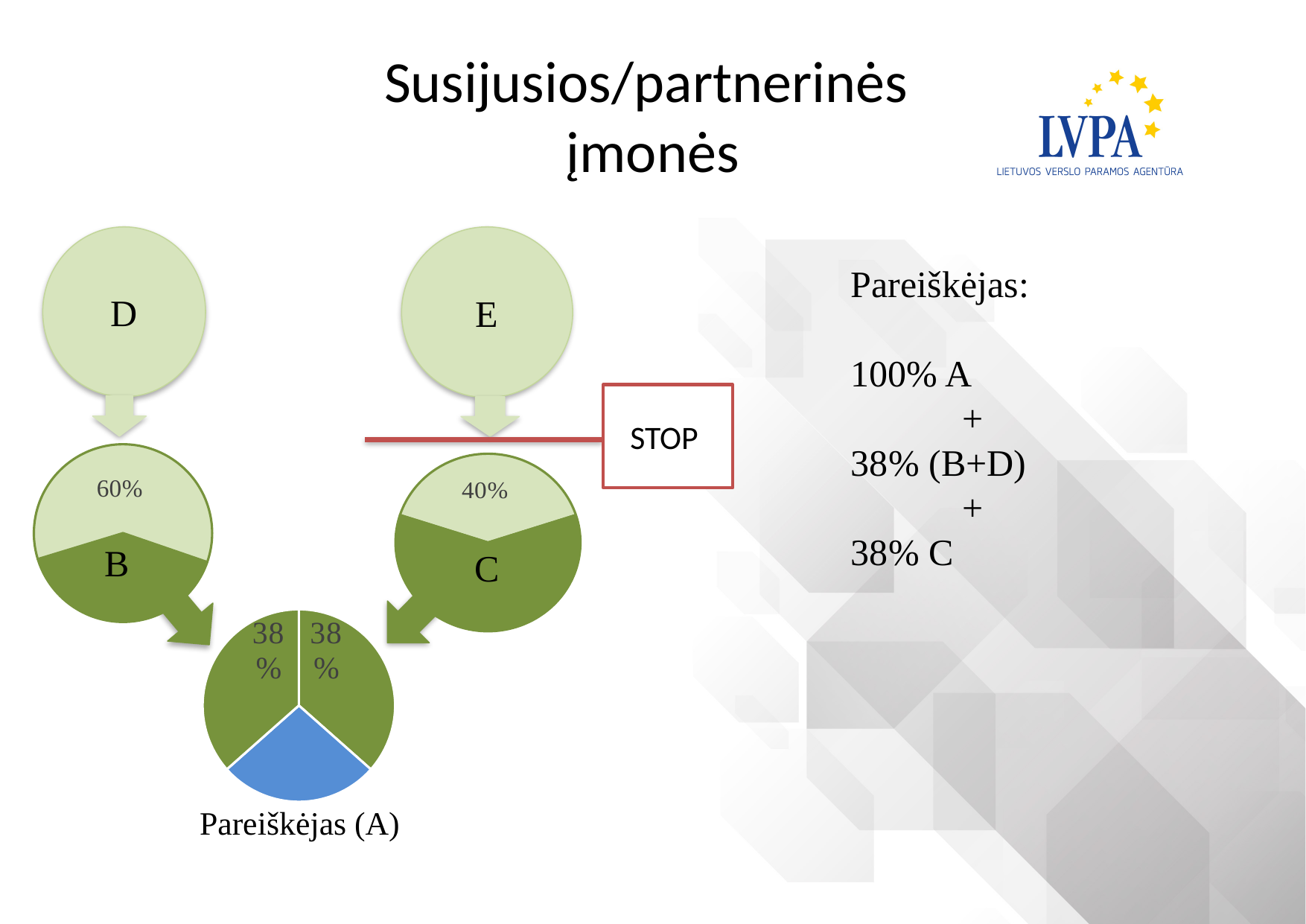
How many slices does the 'Pareiškėjas (A)' pie have? 3 What is the combined share of the two green slices labelled 38% in the 'Pareiškėjas (A)' pie? 76% Which is larger, the percentage shown in circle B or the percentage shown in circle C? circle B What kind of chart is the 'Pareiškėjas (A)' diagram at the bottom of the slide? pie chart What percentage is printed on the left green slice of the 'Pareiškėjas (A)' pie? 38% What percentage is printed in the light green part of the circle labelled C? 40% What percentage is printed in the light green part of the circle labelled B? 60% What percentage is printed on the right green slice of the 'Pareiškėjas (A)' pie? 38% What colour is the unlabelled slice of the 'Pareiškėjas (A)' pie? blue What word is written in the red-bordered box next to the line above circle C? STOP Which circle shows the lower percentage, B or C? C What is the difference between the percentage shown in circle B and the percentage shown in circle C? 20%